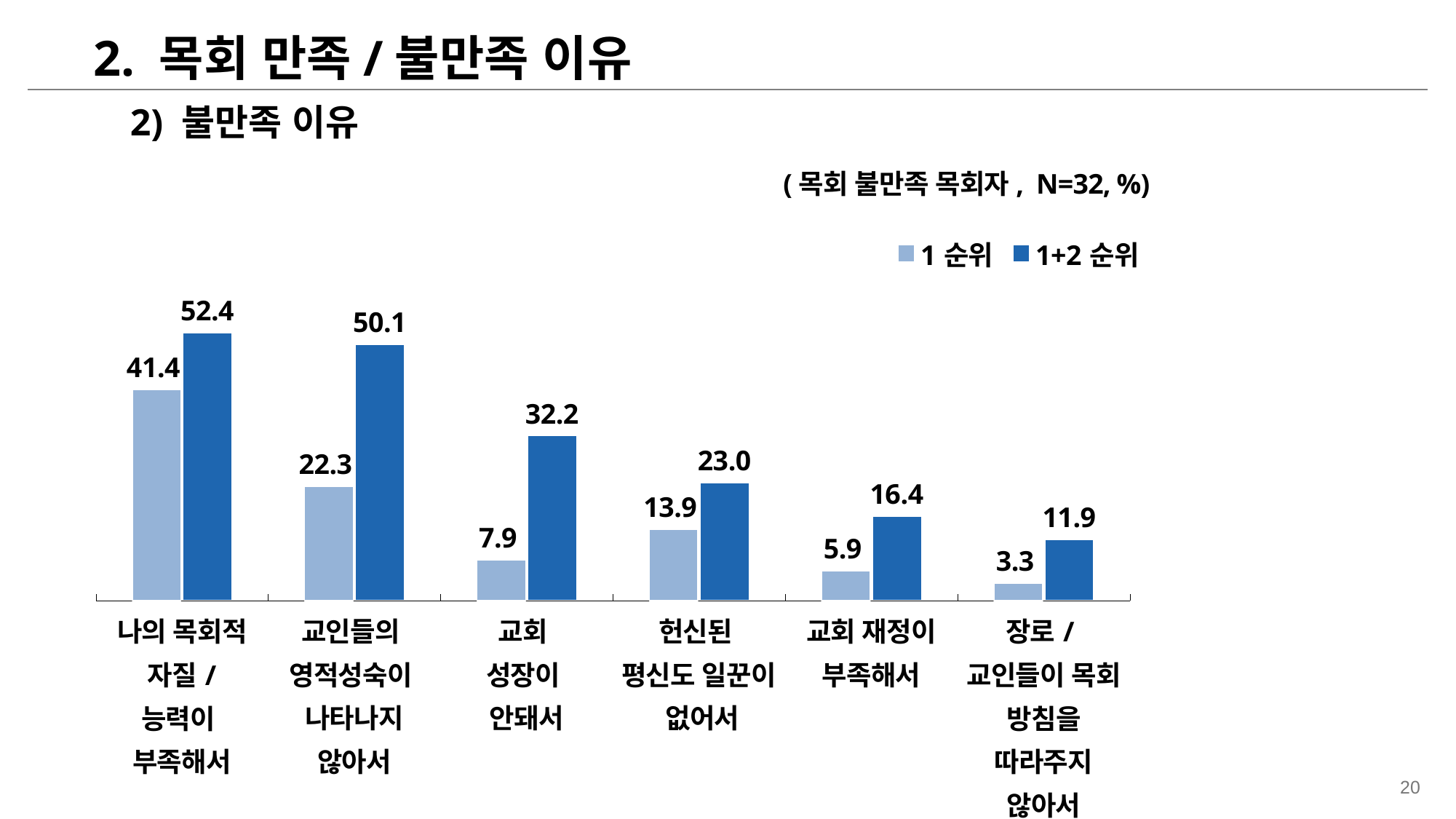
Which category has the highest 1+2 순위 value? 나의 목회적 자질 / 능력이 부족해서 What is the 1+2 순위 value for 헌신된 평신도 일꾼이 없어서? 23.0 What is the 1+2 순위 value for 나의 목회적 자질 / 능력이 부족해서? 52.4 Which is larger: the 1 순위 value for 헌신된 평신도 일꾼이 없어서 or the 1+2 순위 value for 장로 / 교인들이 목회 방침을 따라주지 않아서? 1 순위 value for 헌신된 평신도 일꾼이 없어서 What is the 1 순위 value for 교회 성장이 안돼서? 7.9 What is the difference between the 1+2 순위 and 1 순위 values for 교회 재정이 부족해서? 10.5 What kind of chart is shown on the slide? Bar chart How many categories are shown on the chart? 6 What is the 1 순위 value for 교인들의 영적성숙이 나타나지 않아서? 22.3 What is the sample size (N) stated on the slide? N=32 How many series does the legend list? 2 Which category has the lowest 1 순위 value? 장로 / 교인들이 목회 방침을 따라주지 않아서